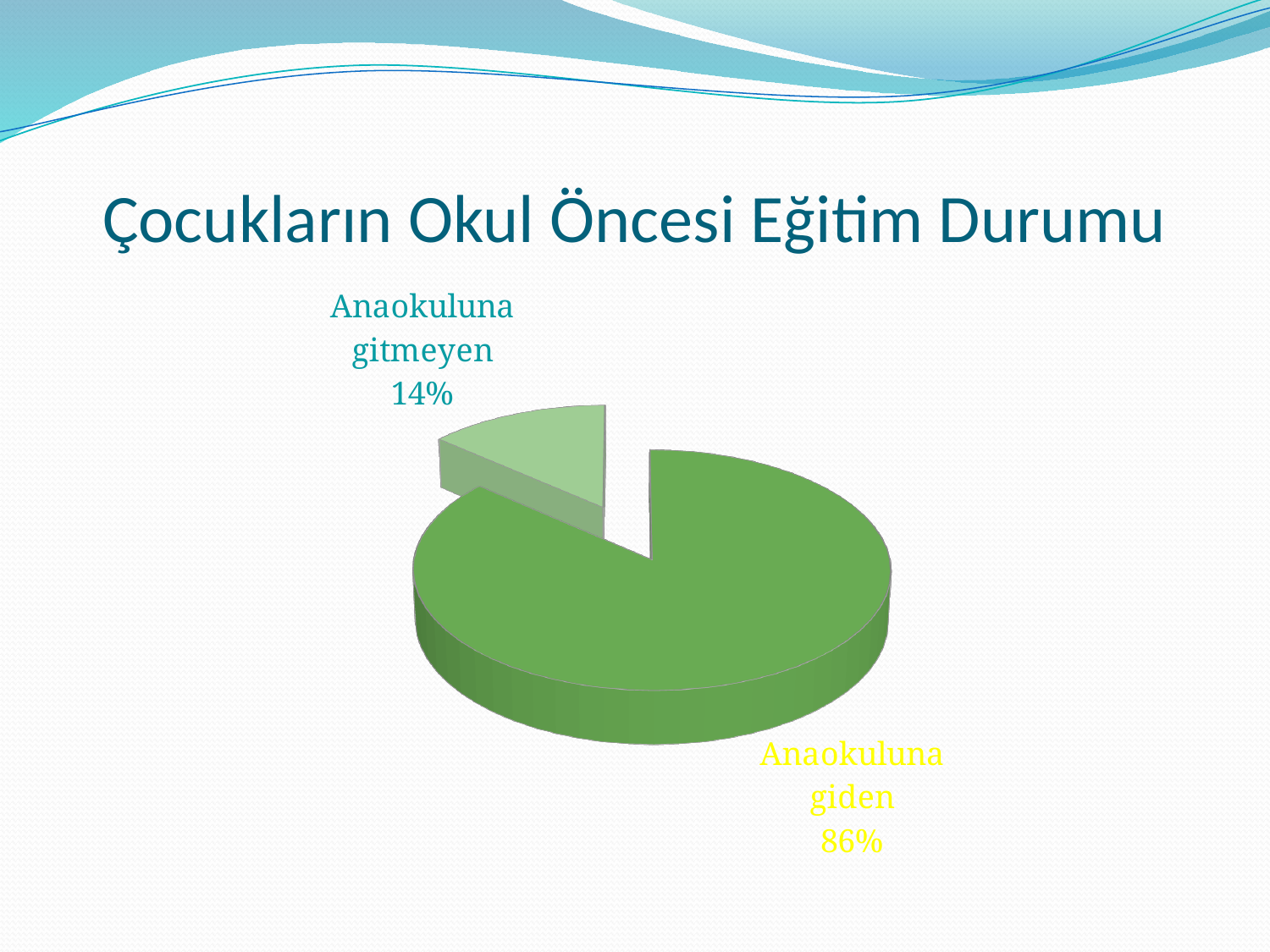
What is the difference in percentage points between "Anaokuluna giden" and "Anaokuluna gitmeyen"? 72 What share of the pie does "Anaokuluna gitmeyen" represent? 14% What share of the pie does "Anaokuluna giden" represent? 86% Which is larger: the share for "Anaokuluna giden" or for "Anaokuluna gitmeyen"? Anaokuluna giden Which slice is the largest in the pie chart? Anaokuluna giden What is the title of the slide containing the chart? Çocukların Okul Öncesi Eğitim Durumu How many slices does the pie chart have? 2 Which slice is pulled out (exploded) from the pie? Anaokuluna gitmeyen What kind of chart is shown on the slide? Pie chart Which slice is the smallest in the pie chart? Anaokuluna gitmeyen